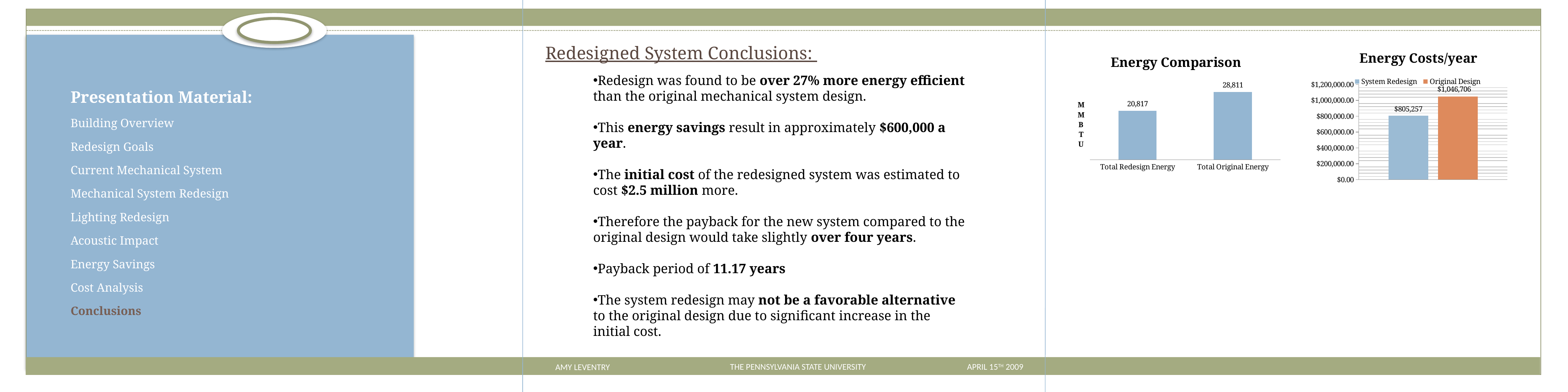
What kind of chart is the Energy Comparison chart? Bar chart In the Energy Comparison chart, what is the value for Total Original Energy? 28,811 In the Energy Costs/year chart, what is the value for System Redesign? $805,257 In the Energy Comparison chart, what is the value for Total Redesign Energy? 20,817 In the Energy Costs/year chart, how many series does the legend list? 2 In the Energy Comparison chart, what is the difference between Total Original Energy and Total Redesign Energy? 7,994 In the Energy Comparison chart, how many bars are plotted? 2 In the Energy Costs/year chart, what colour is the Original Design bar? Orange In the Energy Comparison chart, which category has the higher value? Total Original Energy In the Energy Costs/year chart, what is the value for Original Design? $1,046,706 In the Energy Costs/year chart, what is the difference between Original Design and System Redesign? $241,449 In the Energy Costs/year chart, which series has the lower value? System Redesign